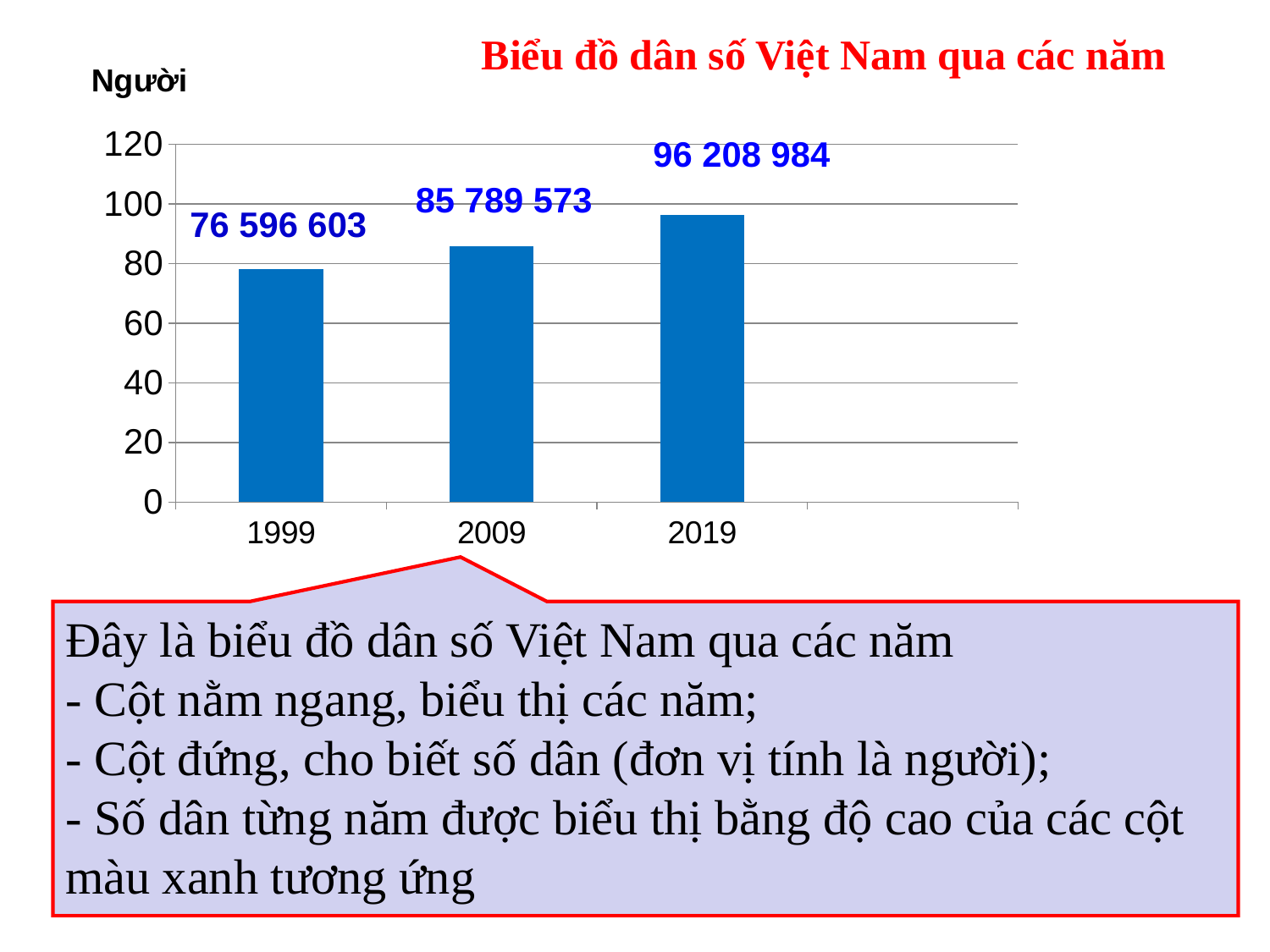
Which year has the lowest population? 1999 Does the population rise or fall from 1999 to 2019? rise Which is larger, the population in 2009 or in 2019? 2019 What is the population value shown for 2009? 85 789 573 Is the bar for 1999 greater or less than 80 on the axis? less What is the population value shown for 1999? 76 596 603 What kind of chart is this? bar chart How many years are shown on the chart? 3 Which year has the highest population? 2019 What is the difference between the population in 2019 and in 1999? 19 612 381 What is the population value shown for 2019? 96 208 984 What is the difference between the population in 2009 and in 1999? 9 192 970